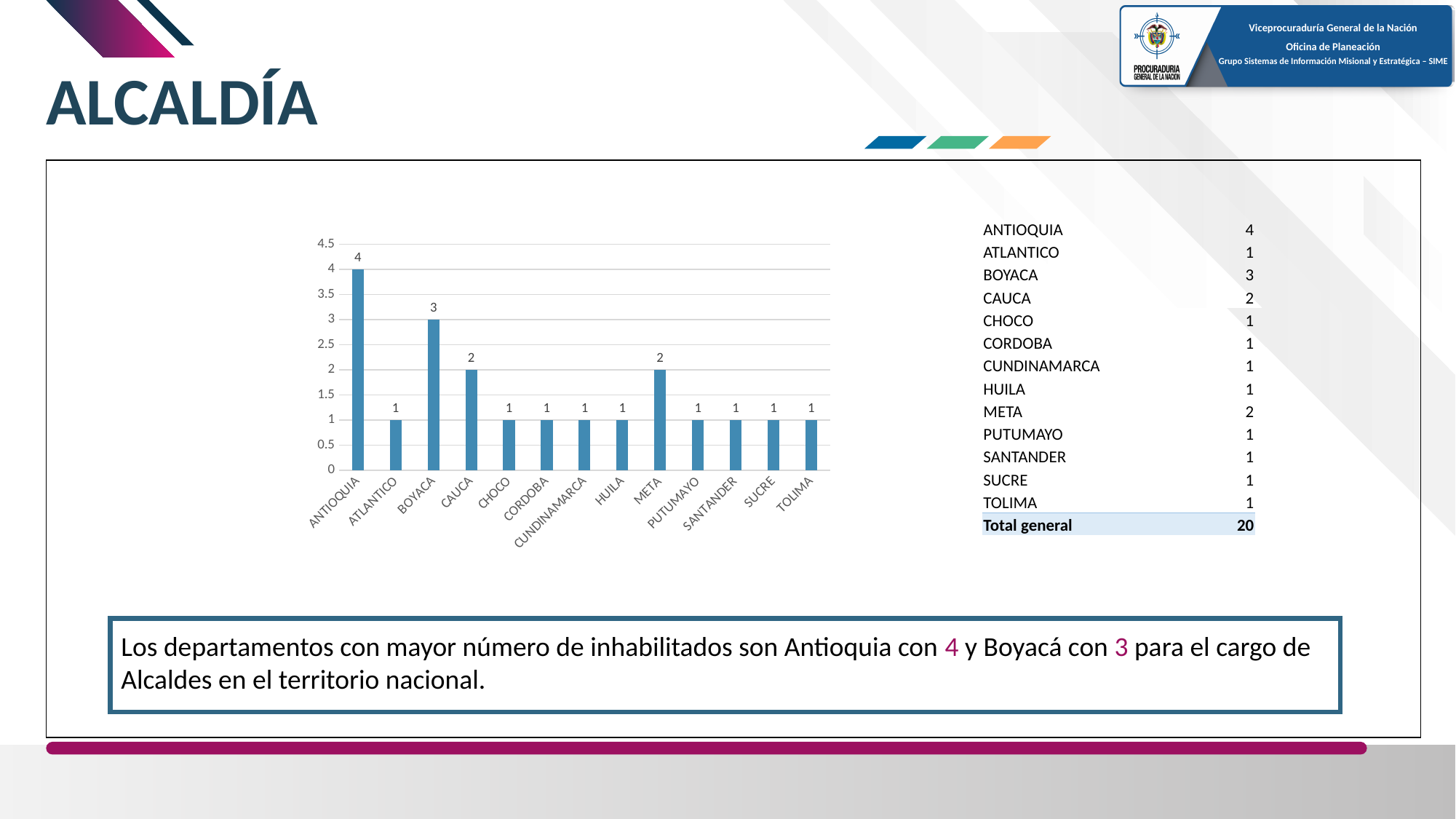
What is the value for META in the bar chart? 2 What is the highest value shown on the y axis of the bar chart? 4.5 What is the value for BOYACA in the bar chart? 3 What is the value for TOLIMA in the bar chart? 1 Which category has the highest value in the bar chart? ANTIOQUIA What is the difference between the values for CAUCA and ATLANTICO? 1 What kind of chart is shown on the slide? bar chart Which is larger, the value for BOYACA or the value for META? BOYACA What is the value for ANTIOQUIA in the bar chart? 4 Is the value for ANTIOQUIA greater or less than 3.5? greater How many categories are shown on the x axis of the bar chart? 13 What is the difference between the values for ANTIOQUIA and BOYACA? 1